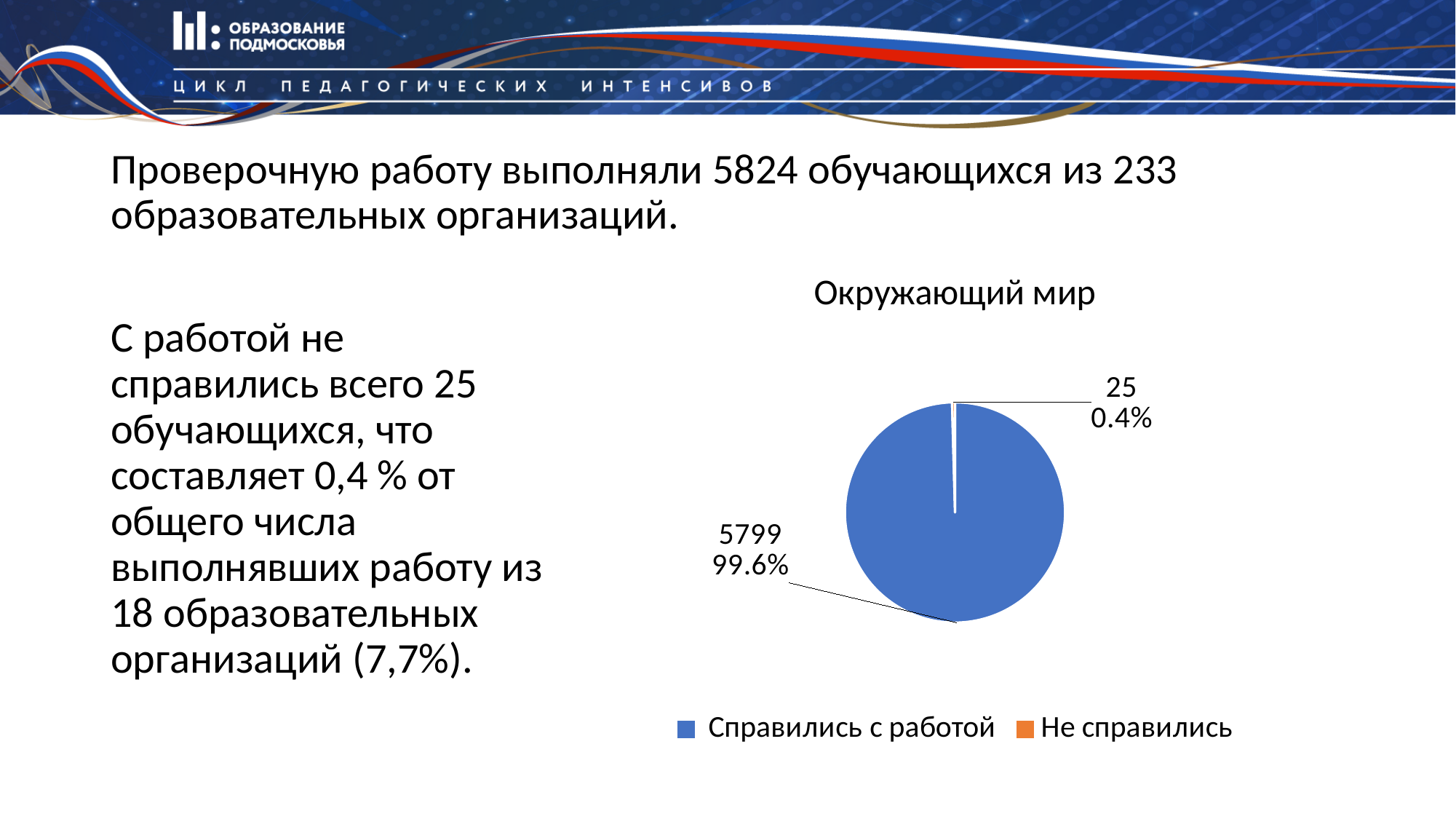
What is the title of the chart? Окружающий мир What kind of chart is shown on the slide? pie chart Which is larger, the value for "Справились с работой" or "Не справились"? Справились с работой What is the difference between the values for "Справились с работой" and "Не справились"? 5774 What colour is the slice for "Справились с работой"? blue How many series does the legend list? 2 Which category has the smallest slice? Не справились What share of the pie does "Не справились" take? 0.4% Which category has the largest slice? Справились с работой What is the value for "Справились с работой"? 5799 What is the value for "Не справились"? 25 What share of the pie does "Справились с работой" take? 99.6%